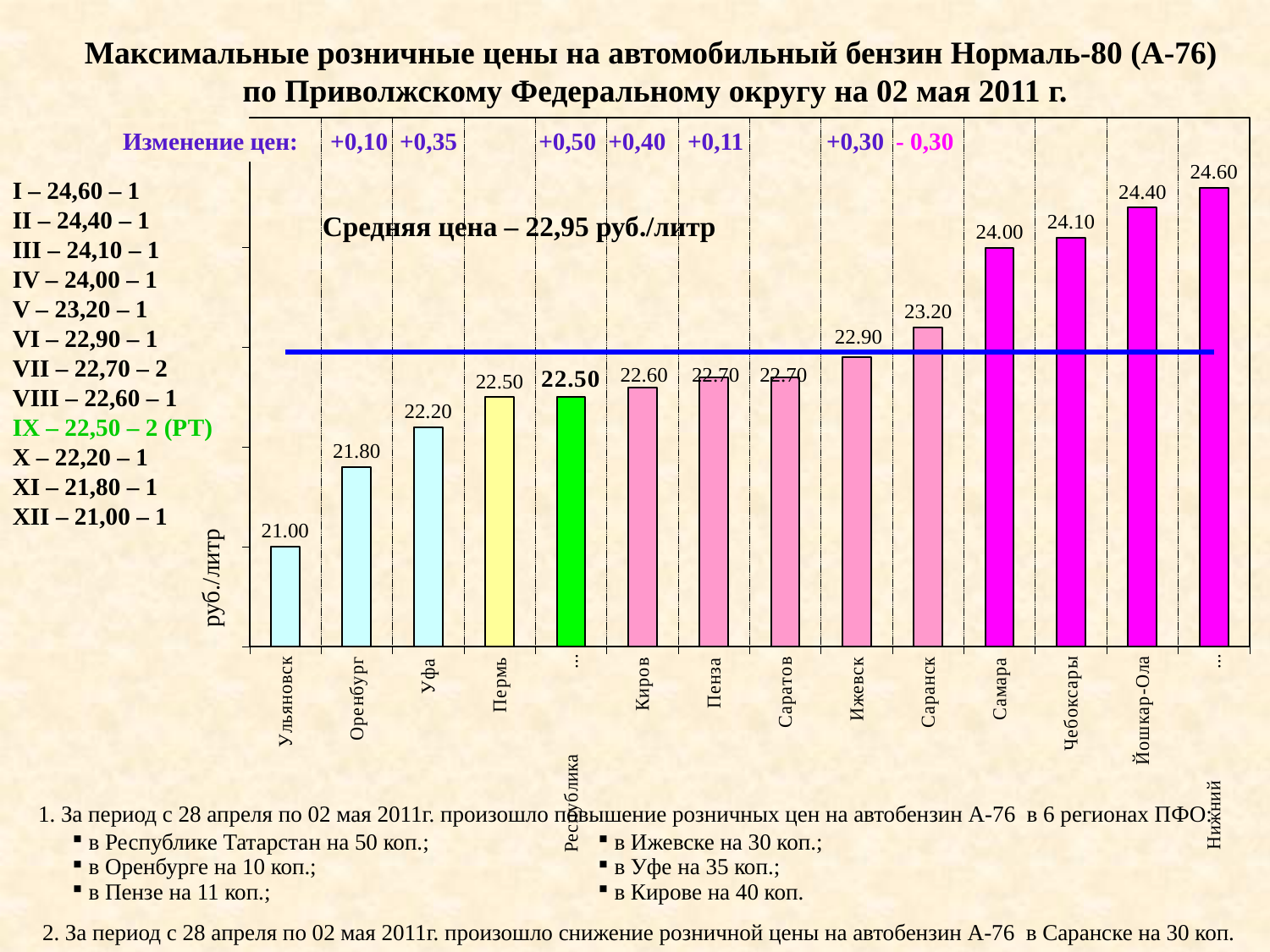
What is the value for Ульяновск? 21.00 What is the difference between the values for Йошкар-Ола and Самара? 0.40 Which is larger, the value for Оренбург or the value for Уфа? Уфа What average price is stated on the chart? 22,95 руб./литр What is the value for Ижевск? 22.90 How many bars are plotted in the chart? 14 Do the values rise or fall from left to right along the x axis? rise What is the value for Саранск? 23.20 Which category has the highest value? Нижний Which category has the lowest value? Ульяновск What is the value for Чебоксары? 24.10 What kind of chart is shown on the slide? bar chart